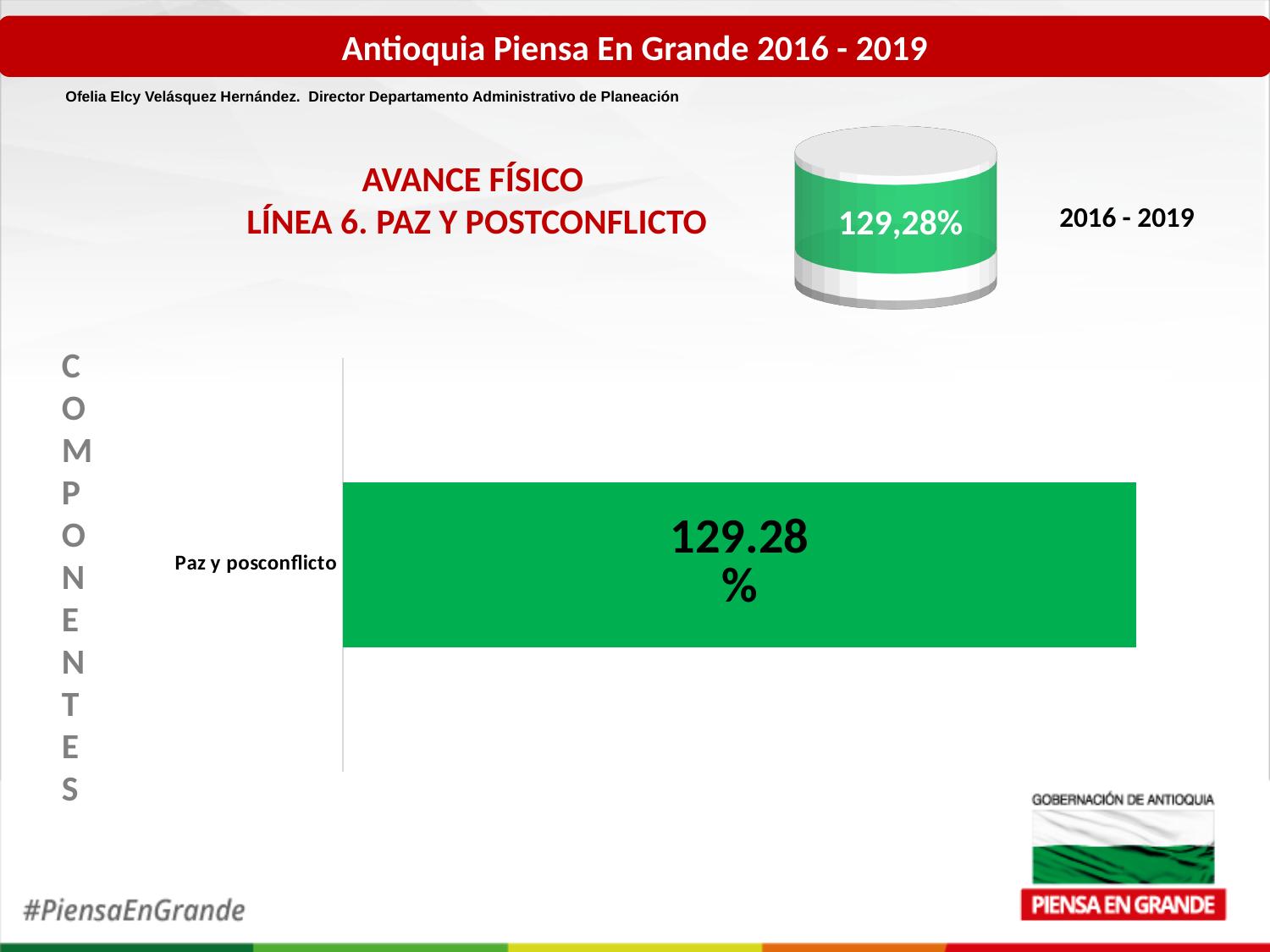
How many categories does the bar chart show? 1 What colour is the bar for Paz y posconflicto? Green What value is shown for Paz y posconflicto in the bar chart? 129.28% What percentage is displayed on the cylinder graphic next to the title 'AVANCE FÍSICO LÍNEA 6. PAZ Y POSTCONFLICTO'? 129,28% Is the bar for Paz y posconflicto drawn horizontally or vertically? Horizontally What is the label of the only bar in the chart? Paz y posconflicto What kind of chart is shown in the lower part of the slide? Bar chart Does the value for Paz y posconflicto exceed 100%? Yes